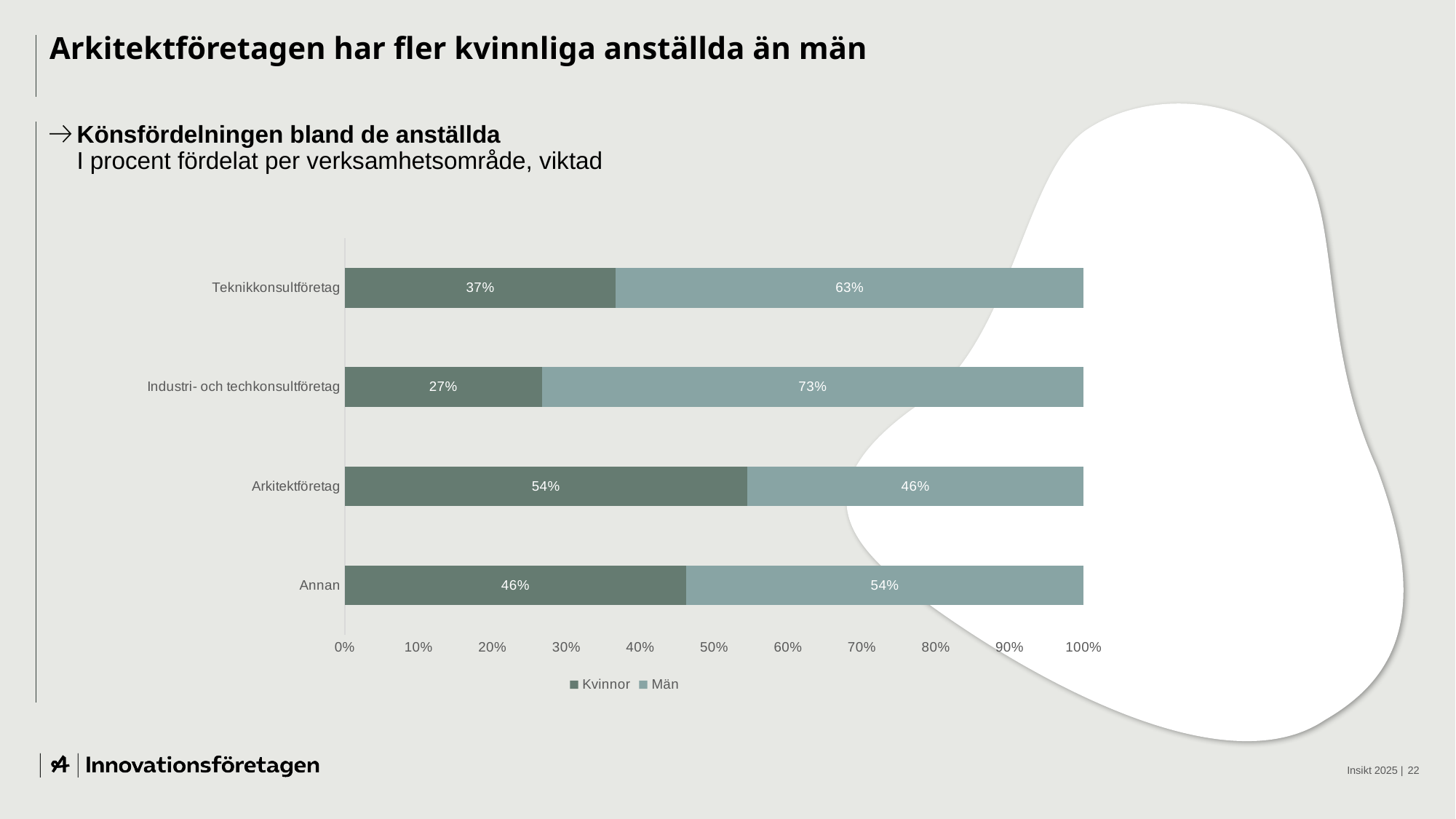
What is the Kvinnor value for Arkitektföretag? 54% How many series does the legend list? 2 What is the difference between the Män and Kvinnor values for Teknikkonsultföretag? 26% How many categories are shown on the chart? 4 What is the Män value for Annan? 54% What is the Män value for Industri- och techkonsultföretag? 73% What is the Kvinnor value for Teknikkonsultföretag? 37% What kind of chart is shown on the slide? Stacked bar chart Which category has the highest Kvinnor value? Arkitektföretag Which category has the lowest Kvinnor value? Industri- och techkonsultföretag Which is larger for Annan, the Kvinnor value or the Män value? Män What is the total of the stacked bar for Industri- och techkonsultföretag? 100%